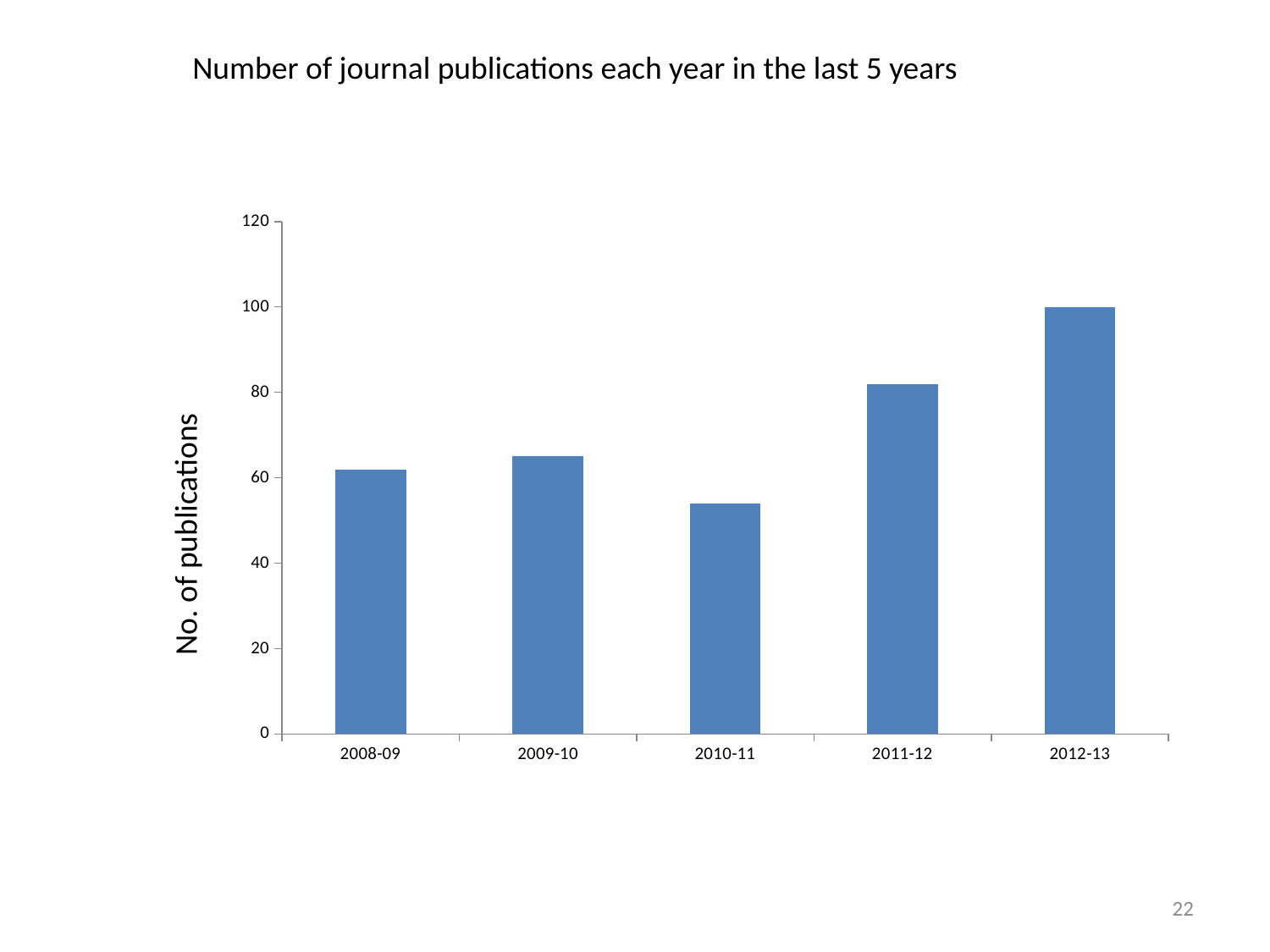
How many years are shown on the x axis of the chart? 5 What kind of chart is shown on the slide? bar chart Which year has the highest number of journal publications? 2012-13 Is the value for 2011-12 greater or less than 60? greater Is the value for 2008-09 greater or less than 80? less What is the number of publications for 2012-13? 100 Which year has more publications, 2011-12 or 2009-10? 2011-12 Is the value for 2009-10 greater or less than 60? greater What is the label on the y axis of the chart? No. of publications Which year has the lowest number of journal publications? 2010-11 Do the values rise or fall from 2010-11 to 2012-13? rise